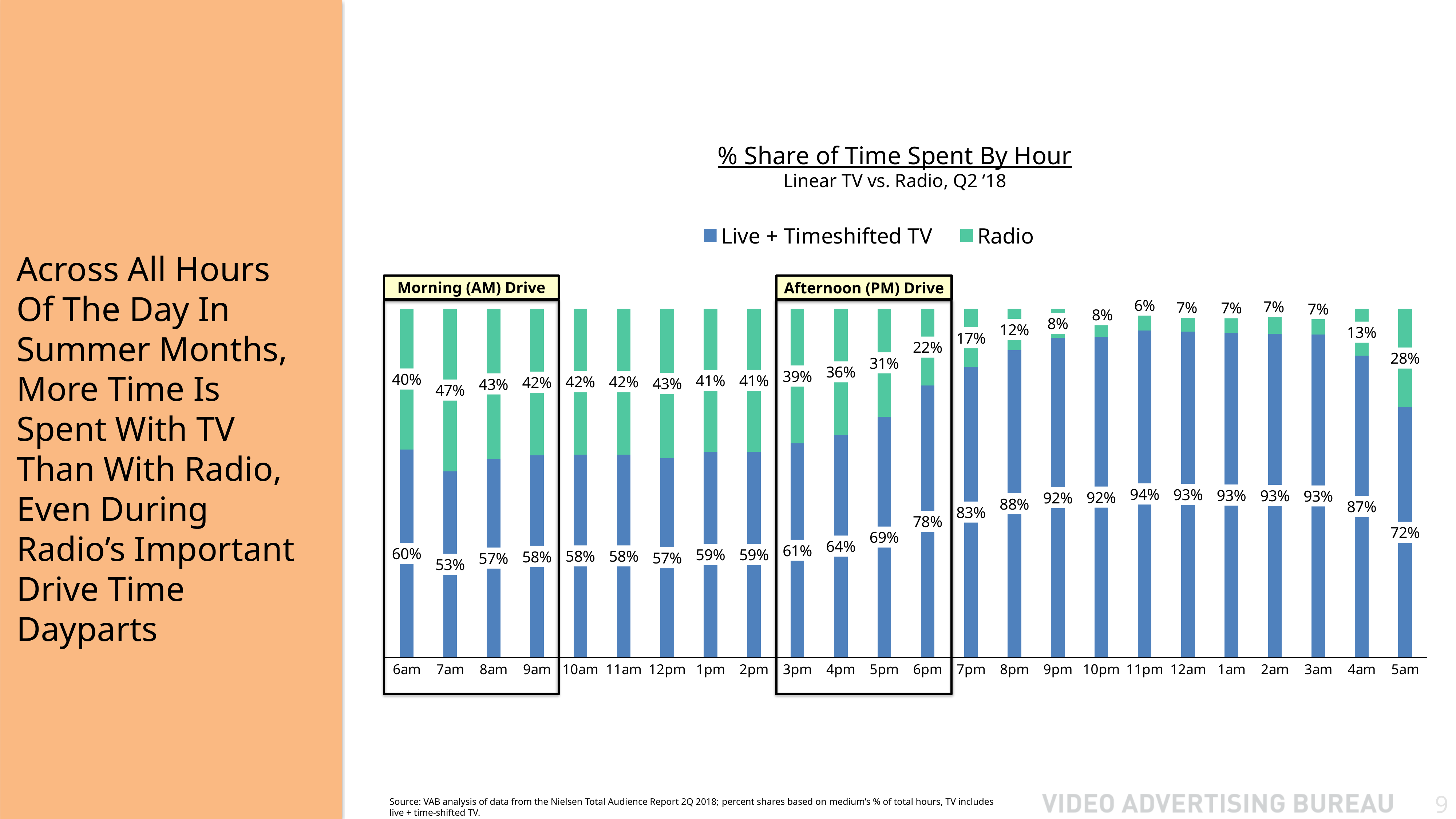
At which hour is the Radio share highest? 7am How many series does the legend list? 2 What kind of chart is shown? Stacked bar chart At which hour is the Live + Timeshifted TV share lowest? 7am What is the difference between the Live + Timeshifted TV share and the Radio share at 6am? 20% How many hours are shown on the x axis? 24 Which two dayparts are highlighted with boxes on the chart? Morning (AM) Drive and Afternoon (PM) Drive Which is larger at 4pm: the Live + Timeshifted TV share or the Radio share? Live + Timeshifted TV What is the Radio share at 6pm? 22% At which hour is the Live + Timeshifted TV share highest? 11pm What is the Live + Timeshifted TV share at 7am? 53% What is the Live + Timeshifted TV share at 5am? 72%